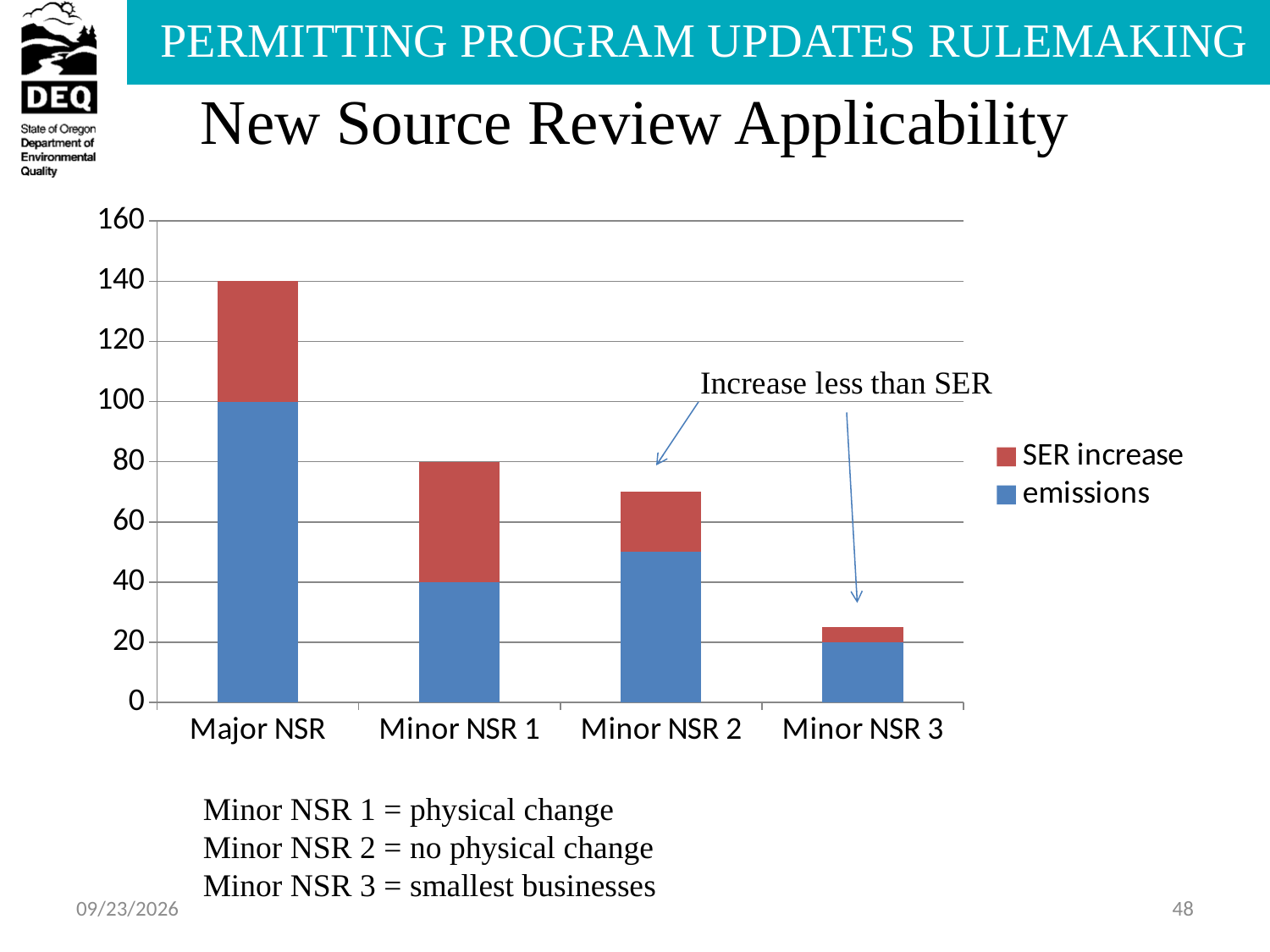
What is the emissions value for Major NSR? 100 Which category has the highest total bar? Major NSR What is the emissions value for Minor NSR 1? 40 Do the total bar heights rise or fall from Major NSR to Minor NSR 3? fall Is the total bar height for Minor NSR 2 greater or less than 60? greater What is the emissions value for Minor NSR 3? 20 What is the total height of the Minor NSR 1 stacked bar? 80 How many categories are shown on the x axis of the chart? 4 What is the total height of the Major NSR stacked bar? 140 What type of chart is shown on the slide? Stacked bar chart Which category has the lowest total bar? Minor NSR 3 How many series does the chart legend list? 2